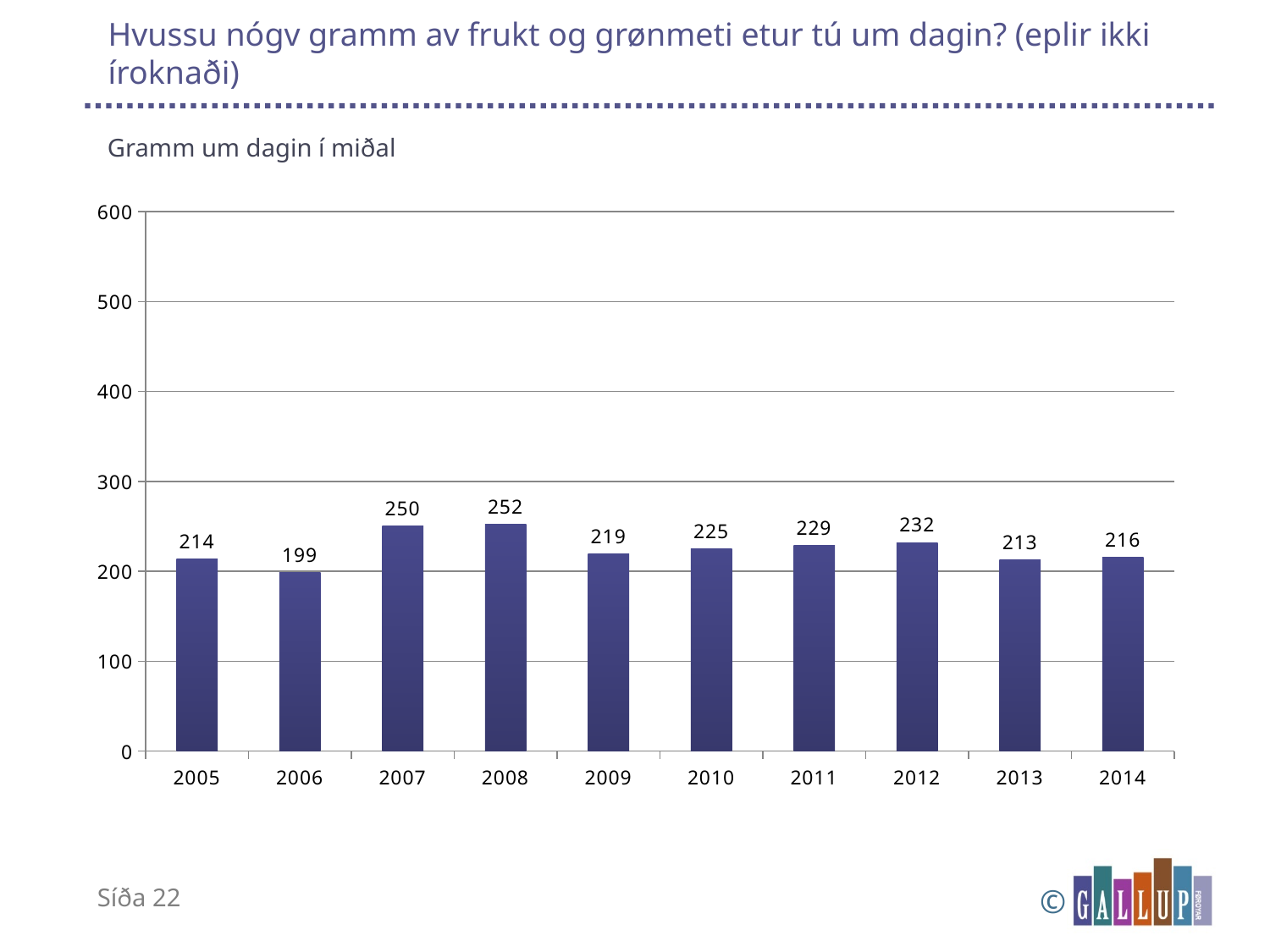
What is the value for 2012? 232 What is the difference between the values for 2012 and 2013? 19 Is the value for 2010 greater or less than 300? less Which is larger, the value for 2007 or the value for 2011? 2007 What kind of chart is shown on the slide? bar chart Which year has the highest value? 2008 What is the subtitle shown above the chart? Gramm um dagin í miðal Which year has the lowest value? 2006 What is the value for 2008? 252 What is the value for 2006? 199 What is the difference between the values for 2008 and 2006? 53 How many years are shown on the x axis? 10